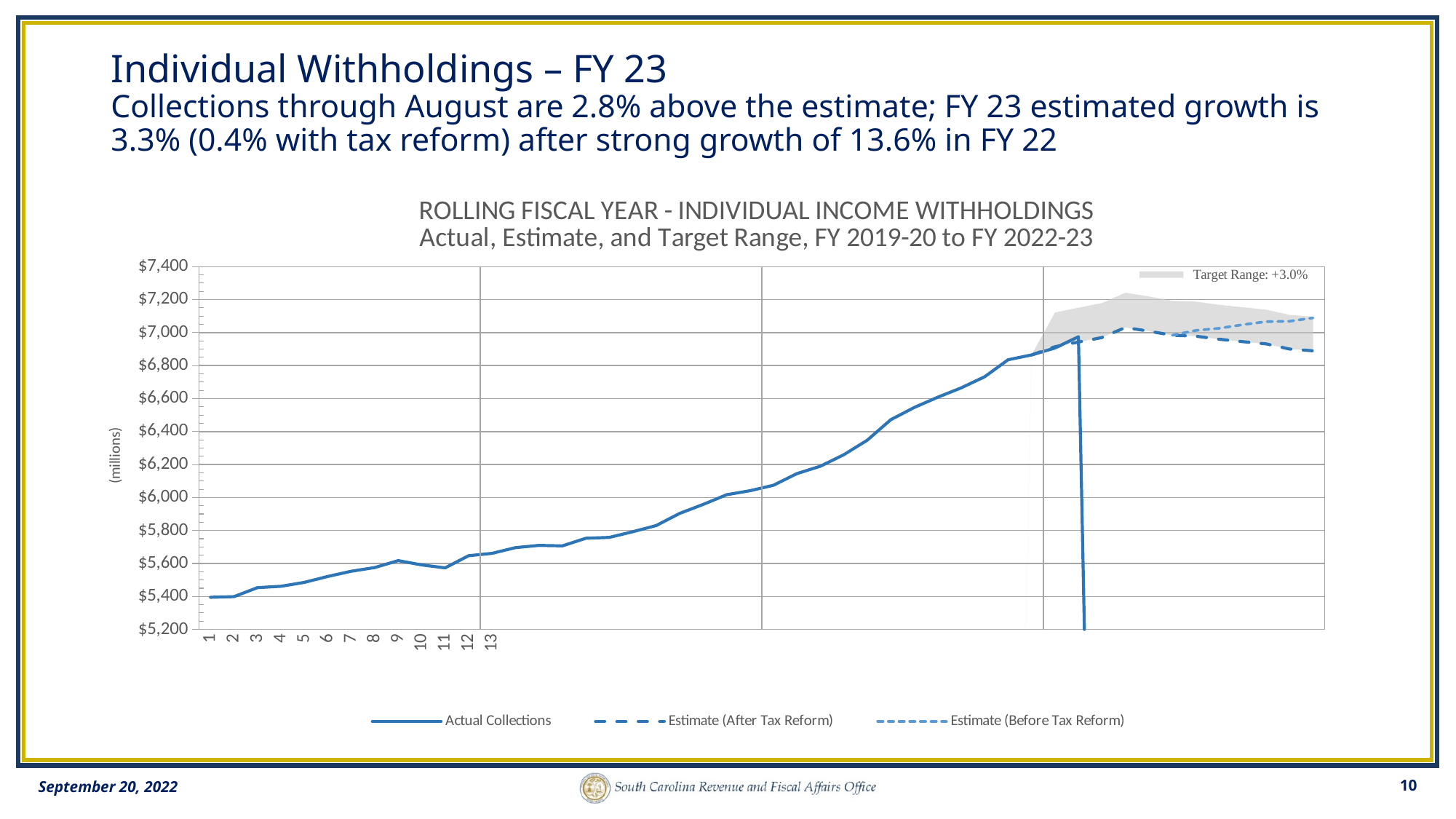
Is the highest value reached by the Actual Collections line greater or less than $6,800? greater What percentage is given for the Target Range in the chart's legend? +3.0% How many series does the legend at the bottom of the chart list? 3 Does the Actual Collections line generally rise or fall from left to right across the chart? rise Is the value of Actual Collections at the first point on the left greater or less than $5,600? less Is the final value of the Estimate (After Tax Reform) line greater or less than $7,000? less What is the highest value shown on the y-axis? $7,400 At the right end of the chart, which is higher: Estimate (Before Tax Reform) or Estimate (After Tax Reform)? Estimate (Before Tax Reform) What kind of chart is shown on the slide? line chart